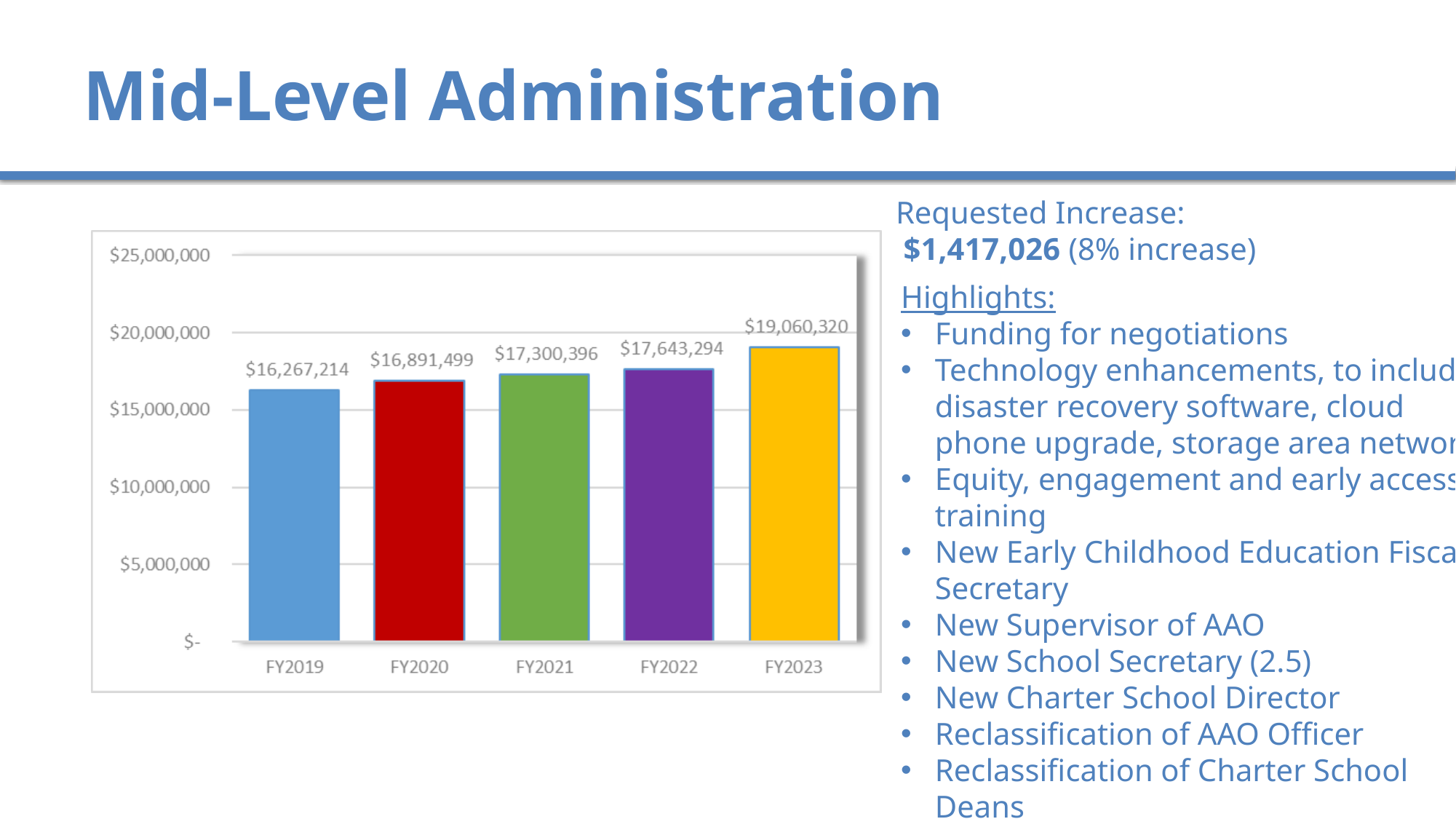
Which is larger, the value for FY2022 or the value for FY2020? FY2022 What kind of chart is shown on the slide? bar chart What is the difference between the FY2020 and FY2019 values? $624,285 How many fiscal years are shown on the chart? 5 What is the value for FY2023? $19,060,320 Is the value for FY2023 greater or less than $20,000,000? less Which fiscal year has the lowest value? FY2019 What is the value for FY2021? $17,300,396 Which fiscal year has the highest value? FY2023 Do the values rise or fall from FY2019 to FY2023? rise What is the value for FY2019? $16,267,214 What is the difference between the FY2023 and FY2022 values? $1,417,026